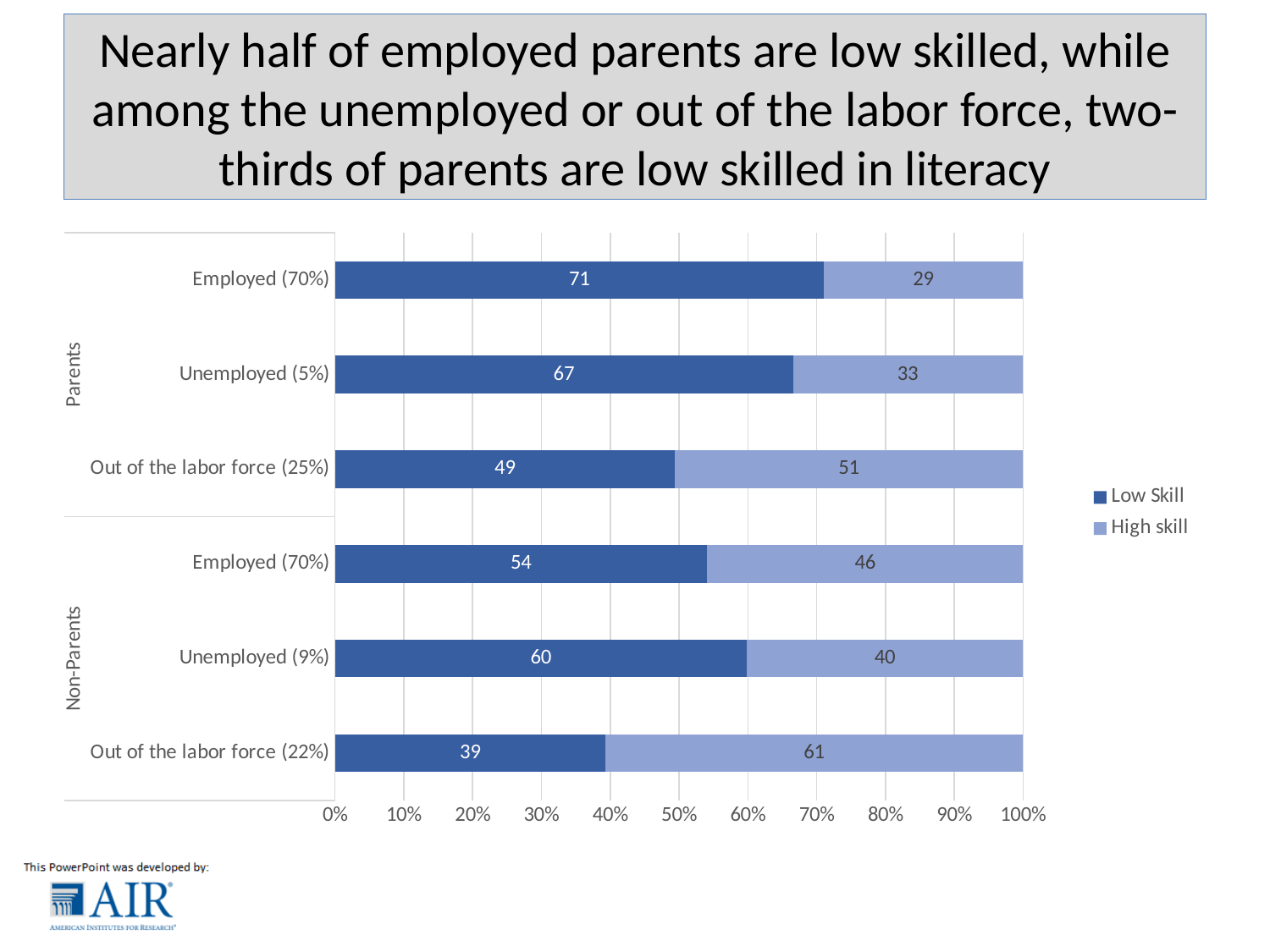
Which category has the highest Low Skill value? Employed (70%) in the Parents group Which category has the lowest Low Skill value? Out of the labor force (22%) in the Non-Parents group Which is larger: the High skill value for Parents Unemployed (5%) or the High skill value for Non-Parents Unemployed (9%)? Non-Parents Unemployed (9%) What kind of chart is shown on the slide? Stacked bar chart How many category bars are plotted in the chart? 6 What is the difference between the Low Skill values for Parents Employed (70%) and Non-Parents Employed (70%)? 17 How many series does the legend list? 2 What is the Low Skill value for Unemployed (9%) in the Non-Parents group? 60 What is the High skill value for Out of the labor force (25%) in the Parents group? 51 What are the two group labels shown on the vertical axis? Parents and Non-Parents What is the High skill value for Out of the labor force (22%) in the Non-Parents group? 61 What is the Low Skill value for Employed (70%) in the Parents group? 71